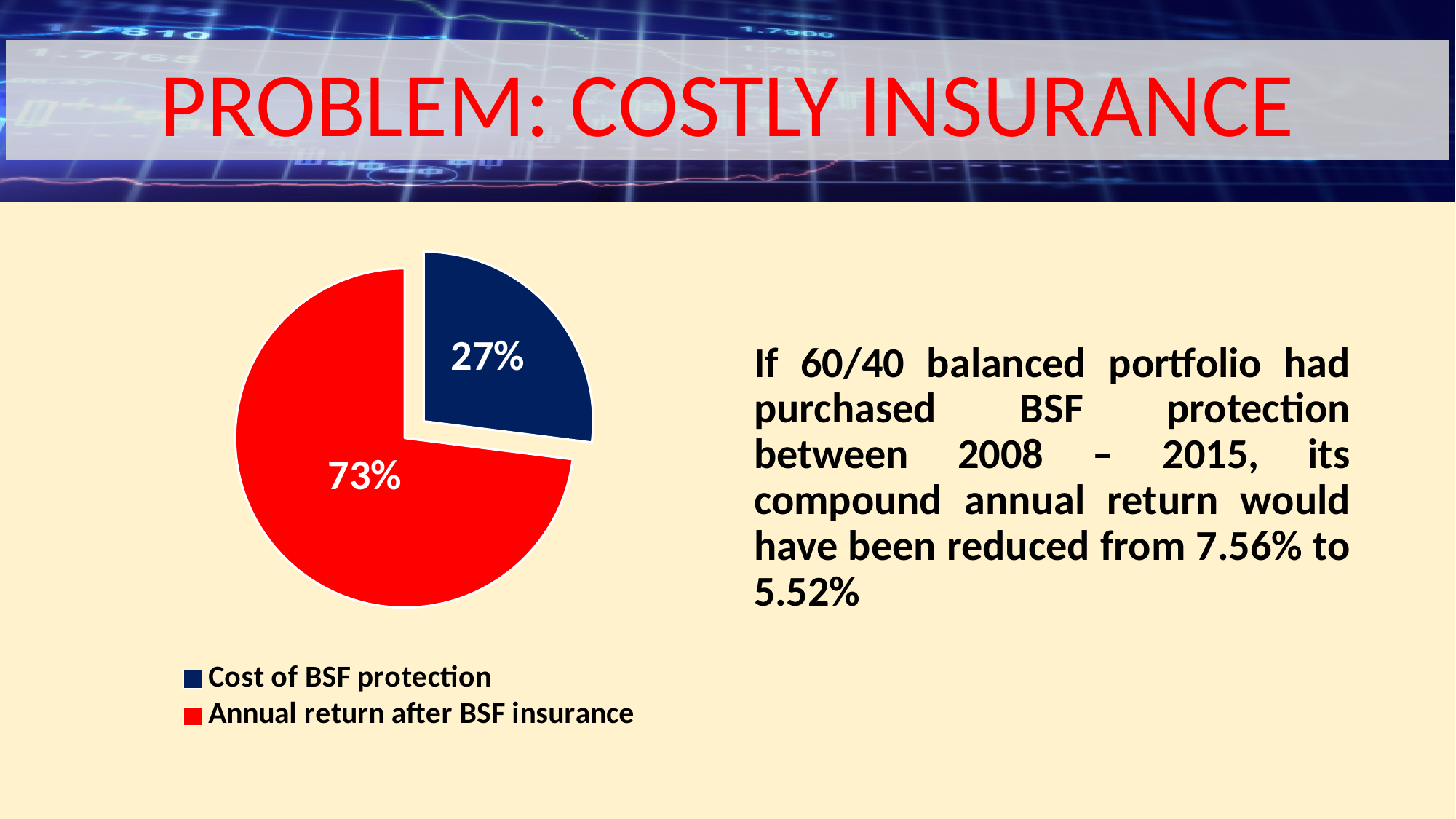
What is the difference in percentage points between the "Annual return after BSF insurance" slice and the "Cost of BSF protection" slice? 46 What share of the pie is labelled "Annual return after BSF insurance"? 73% How many slices does the pie chart have? 2 What kind of chart is shown on the slide? pie chart Which slice of the pie is the smallest? Cost of BSF protection What colour is the "Annual return after BSF insurance" slice? red Which slice of the pie is the largest? Annual return after BSF insurance Which is larger: the "Cost of BSF protection" slice or the "Annual return after BSF insurance" slice? Annual return after BSF insurance What colour is the "Cost of BSF protection" slice? dark blue How many entries does the legend list? 2 What share of the pie is labelled "Cost of BSF protection"? 27%